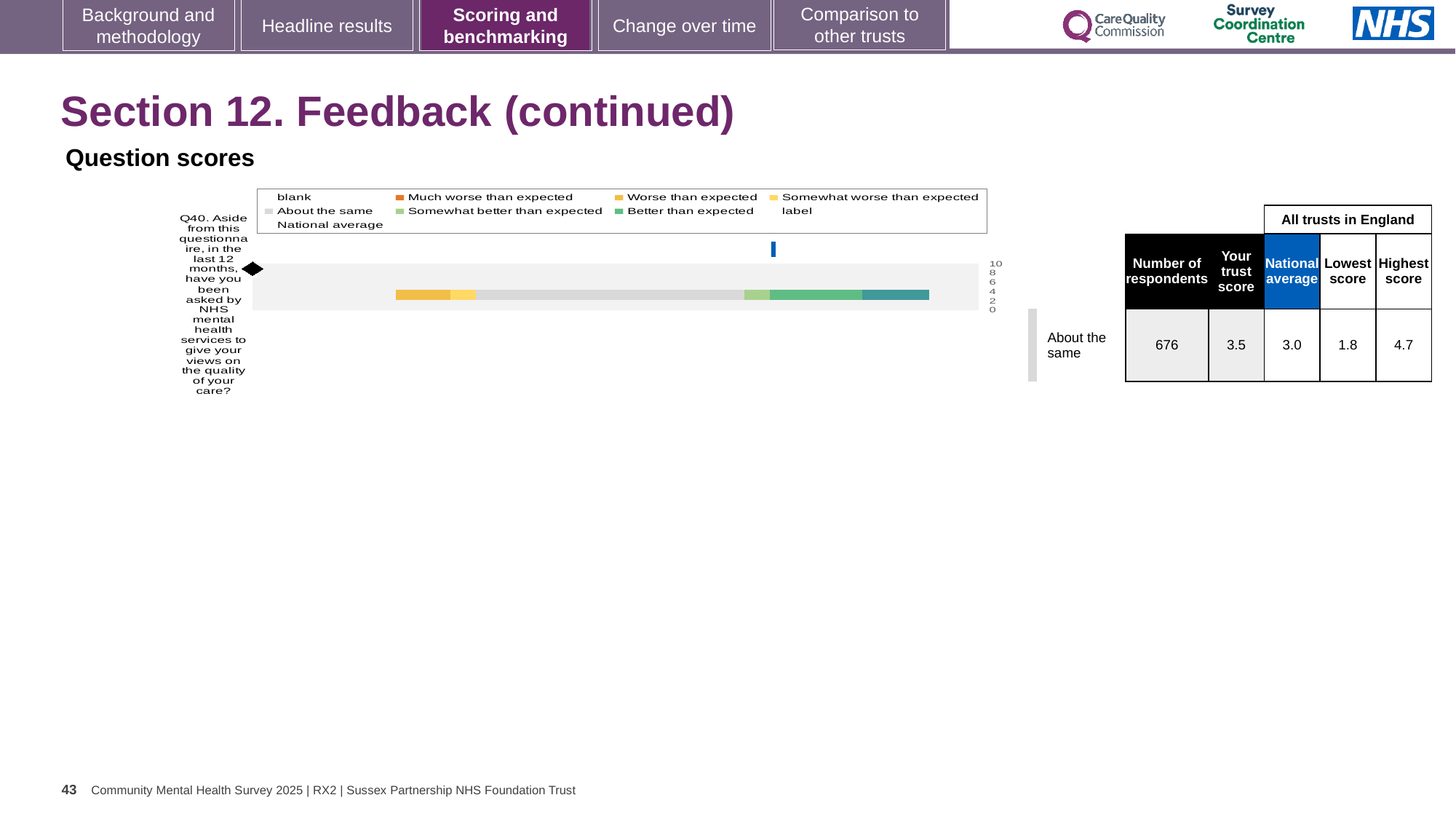
Which is larger for Q40, the trust's score or the national average? the trust's score What is the difference between the trust's score and the national average for Q40? 0.5 Into which benchmarking category does the trust's score for Q40 fall? About the same How many survey questions are plotted in the chart? 1 What is the national average score for Q40? 3.0 What is the trust's score for Q40? 3.5 Which question number is plotted in the chart? Q40 What is the lowest score among all trusts in England for Q40? 1.8 What is the difference between the highest and lowest scores among all trusts in England for Q40? 2.9 What kind of chart is shown on the slide? bar chart What is the highest score among all trusts in England for Q40? 4.7 How many respondents answered Q40? 676